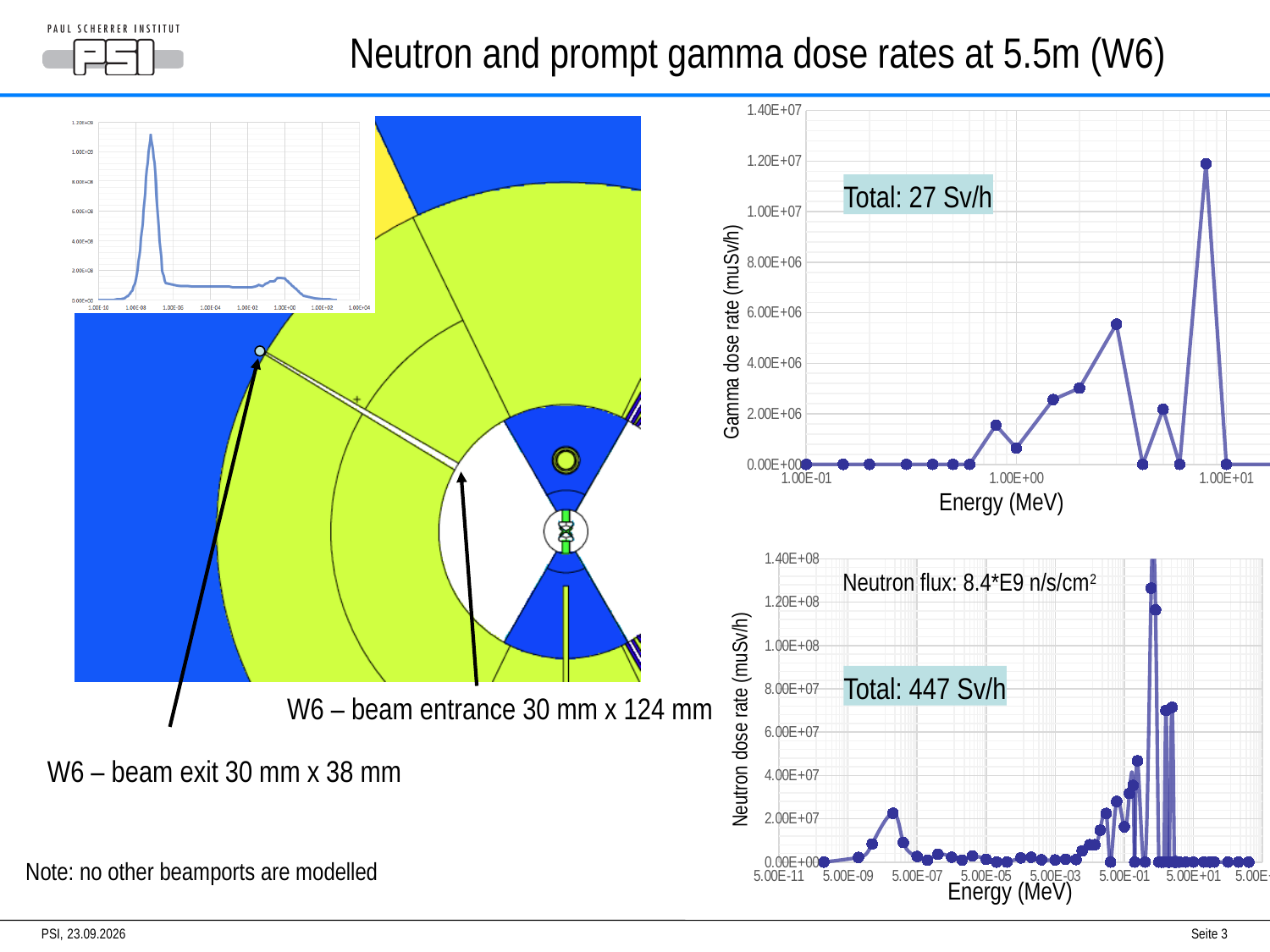
What is the x-axis label of the bottom-right neutron dose rate chart? Energy (MeV) In the bottom-right neutron dose rate chart, is the small peak near 5.00E-08 MeV greater or less than 4.00E+07 muSv/h? less In the bottom-right neutron dose rate chart, is the tallest peak greater or less than 1.00E+08 muSv/h? greater What kind of chart is the bottom-right chart of neutron dose rate versus energy? line chart In the top-right gamma dose rate chart, what total dose rate is printed on the chart? 27 Sv/h In the bottom-right neutron dose rate chart, what total dose rate is printed on the chart? 447 Sv/h What is the y-axis label of the top-right chart? Gamma dose rate (muSv/h) In the top-right gamma dose rate chart, is the value at 1.00E-01 MeV greater or less than 2.00E+06 muSv/h? less What kind of chart is the top-right chart of gamma dose rate versus energy? line chart In the bottom-right neutron dose rate chart, what neutron flux value is printed on the chart? 8.4*E9 n/s/cm² In the top-right gamma dose rate chart, do the values generally rise or fall as energy increases from 1.00E-01 MeV toward 1.00E+01 MeV? rise